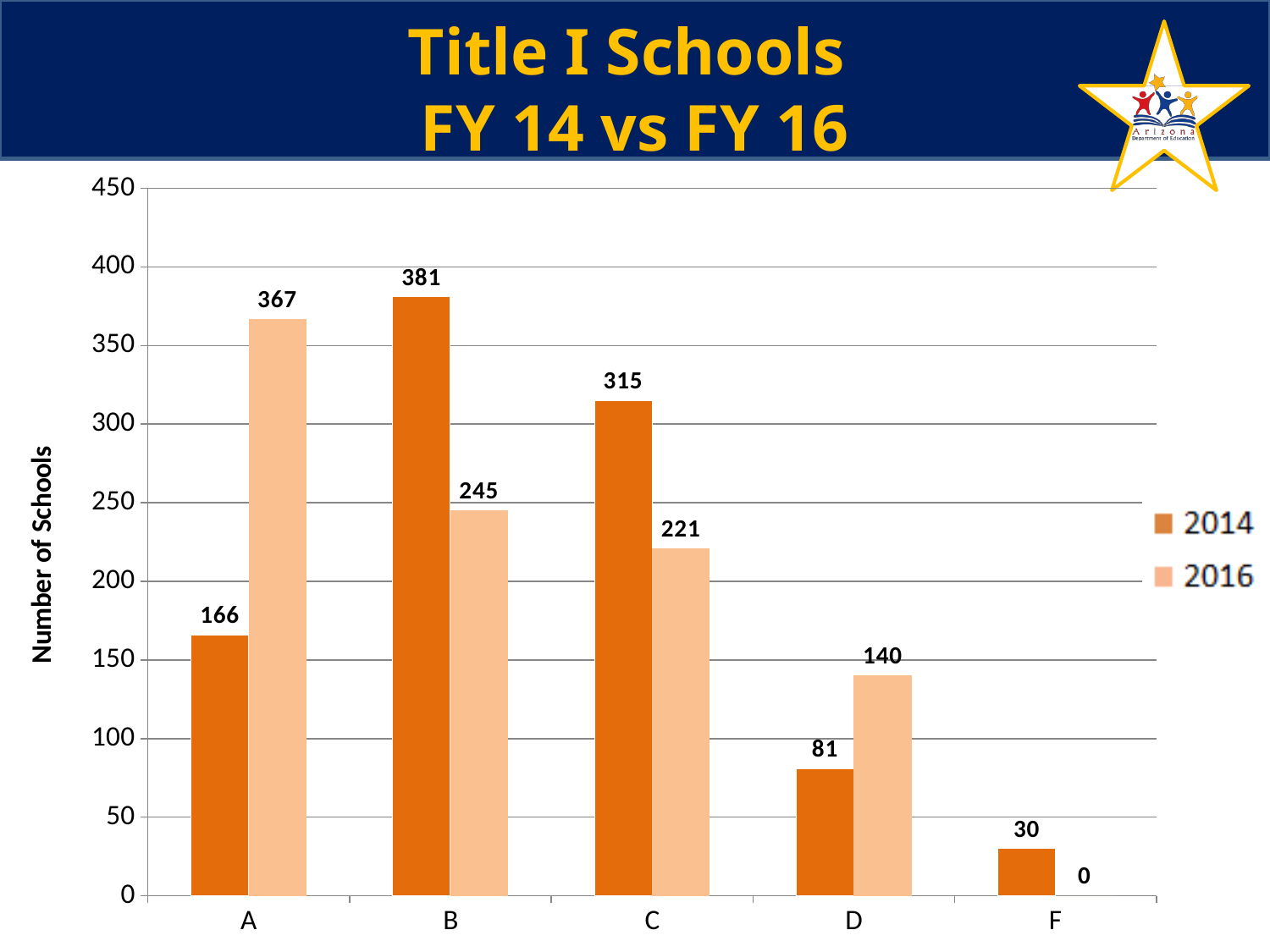
Which grade has the lowest number of schools in 2016? F What is the label of the vertical axis? Number of Schools What is the 2016 value for grade D? 140 What is the 2016 value for grade F? 0 What kind of chart is shown on the slide? Bar chart What is the number of Title I schools with grade A in 2016? 367 What is the difference between the 2014 and 2016 values for grade B? 136 How many grade categories are shown on the x axis? 5 Which is larger for grade C, the 2014 value or the 2016 value? 2014 What is the number of Title I schools with grade A in 2014? 166 How many series does the legend list? 2 Which grade has the highest number of schools in 2014? B